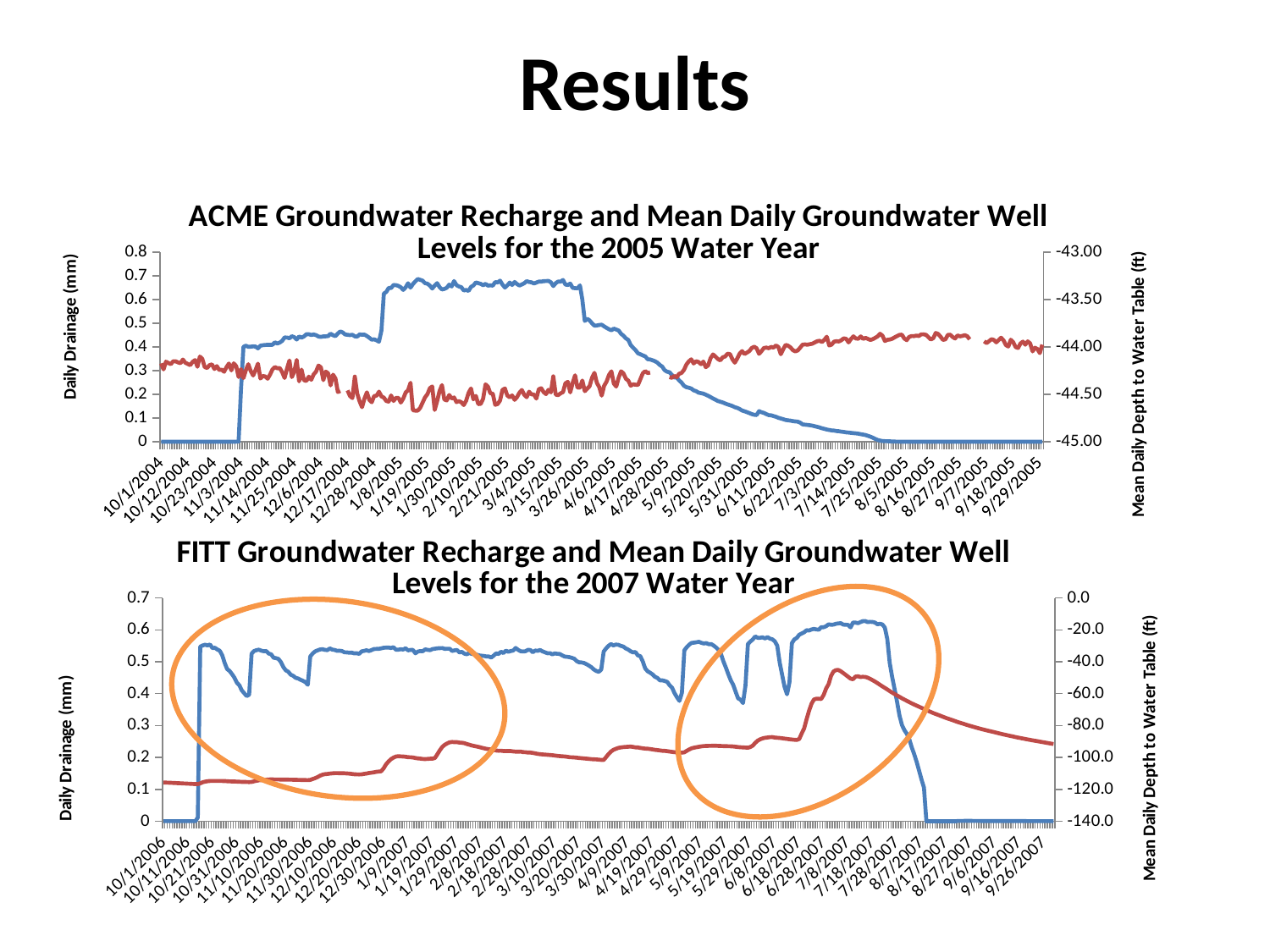
In the top chart (ACME, 2005 Water Year), is the red line's depth to water table on 7/14/2005 greater or less than -44.50? greater In the bottom chart (FITT, 2007 Water Year), does the red depth-to-water-table line rise or fall between 7/18/2007 and 9/26/2007? fall In the top chart (ACME, 2005 Water Year), is the daily drainage value of the blue line on 10/12/2004 greater or less than 0.1? less In the bottom chart (FITT, 2007 Water Year), which date has the higher daily drainage on the blue line: 6/28/2007 or 10/31/2006? 6/28/2007 In the top chart (ACME, 2005 Water Year), does the blue daily drainage line rise or fall between 3/26/2005 and 8/5/2005? fall In the bottom chart (FITT, 2007 Water Year), what is the title of the right vertical axis? Mean Daily Depth to Water Table (ft) What kind of chart is the top chart, 'ACME Groundwater Recharge and Mean Daily Groundwater Well Levels for the 2005 Water Year'? Line chart In the top chart (ACME, 2005 Water Year), what is the title of the left vertical axis? Daily Drainage (mm) In the bottom chart (FITT, 2007 Water Year), is the daily drainage value of the blue line on 1/9/2007 greater or less than 0.4? greater How many charts are shown on the slide? 2 In the top chart (ACME, 2005 Water Year), which date has the higher daily drainage on the blue line: 2/10/2005 or 6/22/2005? 2/10/2005